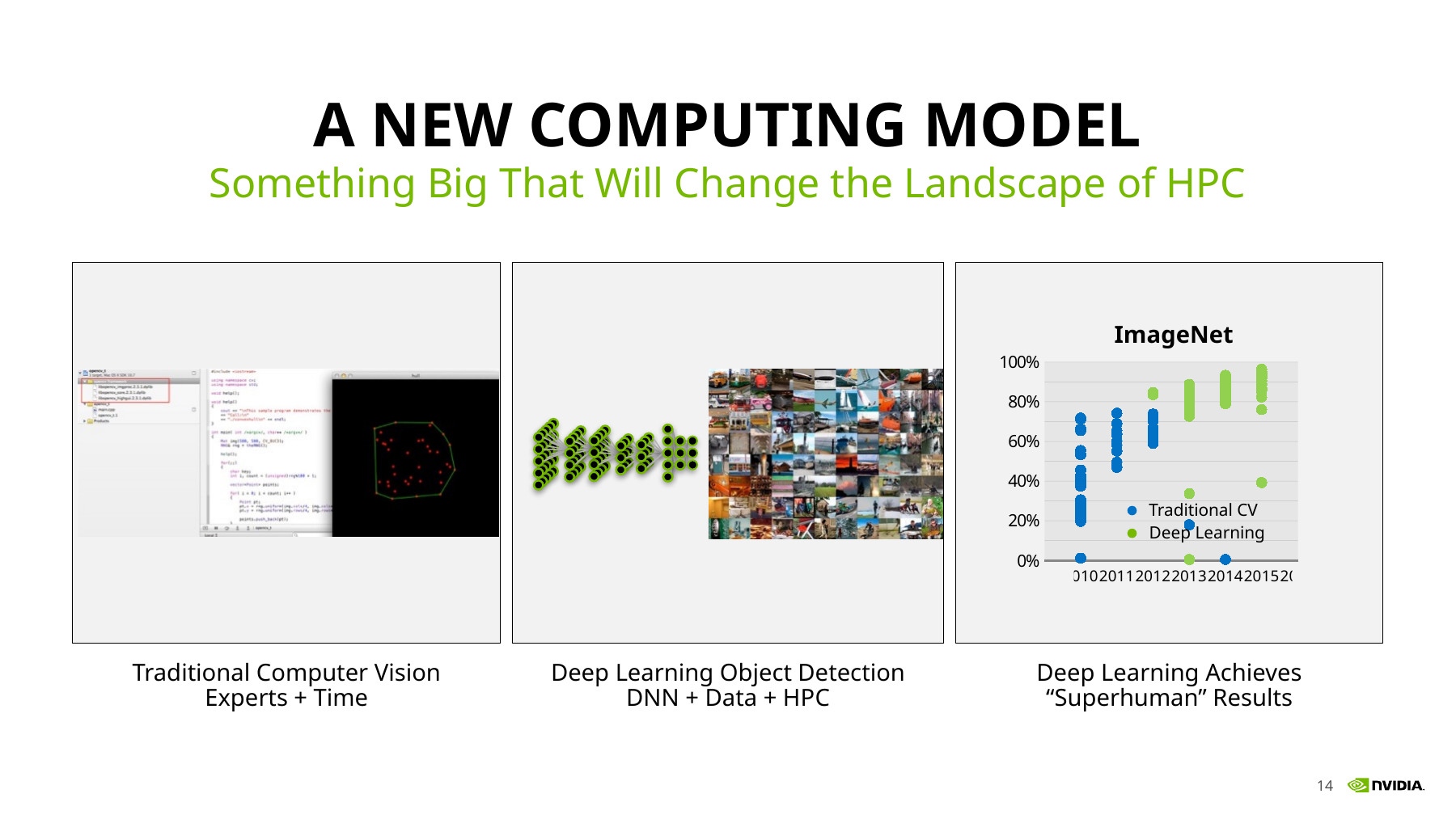
What are the two series named in the legend of the ImageNet chart? Traditional CV and Deep Learning How many series does the legend of the ImageNet chart list? 2 In the ImageNet chart, is the highest Traditional CV value in 2011 greater or less than 60%? greater In the ImageNet chart, which series reaches higher values in 2014, Traditional CV or Deep Learning? Deep Learning What kind of chart is shown in the ImageNet panel on the right of the slide? scatter chart In the ImageNet chart, is the lowest Traditional CV value in 2012 greater or less than 40%? greater In the ImageNet chart, is the highest Deep Learning value in 2015 greater or less than 80%? greater What is the title of the chart on the right of the slide? ImageNet In the ImageNet chart, which series reaches higher values in 2013, Traditional CV or Deep Learning? Deep Learning In the ImageNet chart, do the top Deep Learning values rise or fall from 2012 to 2015? rise